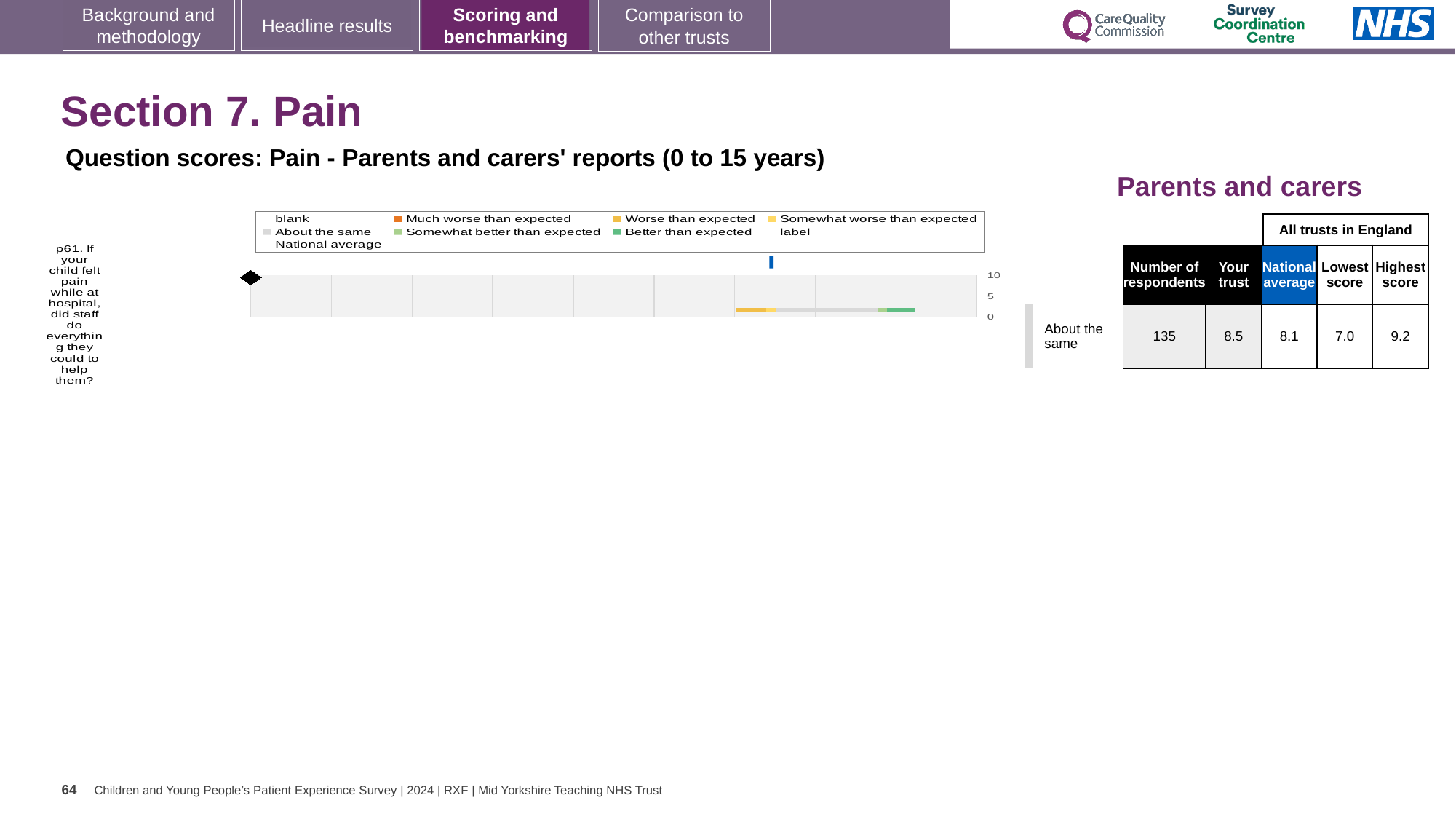
How many respondents answered question p61? 135 Which benchmark category is the trust's result for p61 placed in, according to the label next to the chart? About the same How many survey questions are plotted in the chart? 1 Which is larger for question p61: the 'Your trust' score or the national average? Your trust What is the 'Your trust' score for question p61 in the Parents and carers table? 8.5 What kind of chart is shown on the slide for question p61? bar chart How many entries does the chart legend list? 9 What is the maximum value shown on the chart's score axis? 10 What is the national average score for question p61? 8.1 What is the highest score among all trusts in England for question p61? 9.2 What is the difference between the highest score and the lowest score for question p61? 2.2 What is the lowest score among all trusts in England for question p61? 7.0